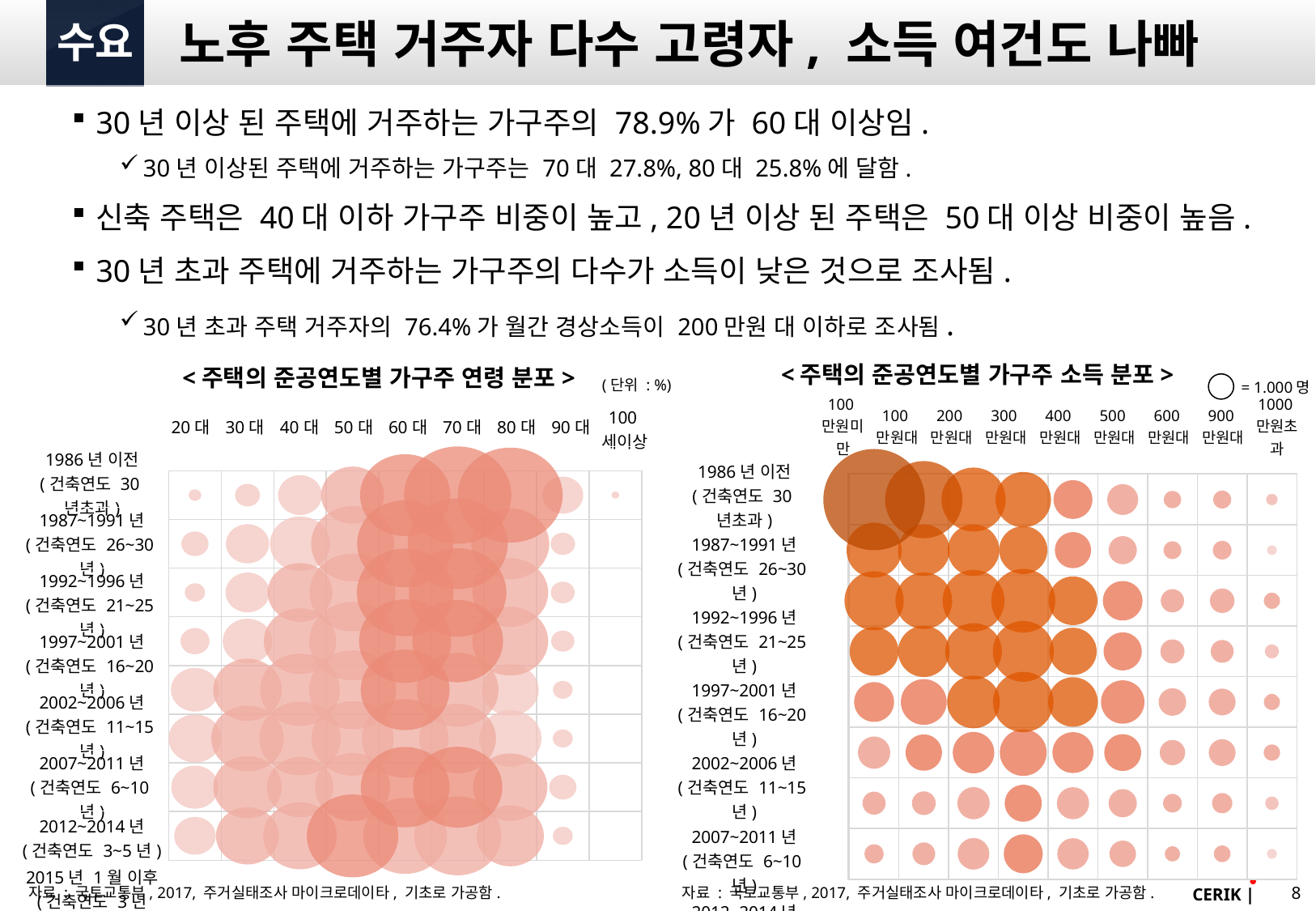
In the right chart (가구주 소득 분포), for the '1987~1991년' row, which is larger: the bubble for 100만원대 or the bubble for 1000만원초과? 100만원대 In the right chart (가구주 소득 분포), for the '1986년 이전' row, which is larger: the bubble for 100만원미만 or the bubble for 900만원대? 100만원미만 In the left chart (가구주 연령 분포), for the '1986년 이전' row, which is larger: the bubble for 20대 or the bubble for 70대? 70대 What kind of chart is the right chart titled '주택의 준공연도별 가구주 소득 분포'? bubble chart In the left chart (가구주 연령 분포), what unit is stated for the values? % In the right chart (가구주 소득 분포), how many income categories are shown along the x axis? 9 In the right chart (가구주 소득 분포), for the '1986년 이전' row, which income category has the largest bubble? 100만원미만 What kind of chart is the left chart titled '주택의 준공연도별 가구주 연령 분포'? bubble chart In the left chart (가구주 연령 분포), how many completion-year rows are listed on the y axis? 8 In the left chart (가구주 연령 분포), how many age categories are shown along the x axis? 9 In the right chart (가구주 소득 분포), what does one reference circle in the legend represent? 1,000명 In the left chart (가구주 연령 분포), for the '1986년 이전' row, which age category has the smallest bubble? 100세이상